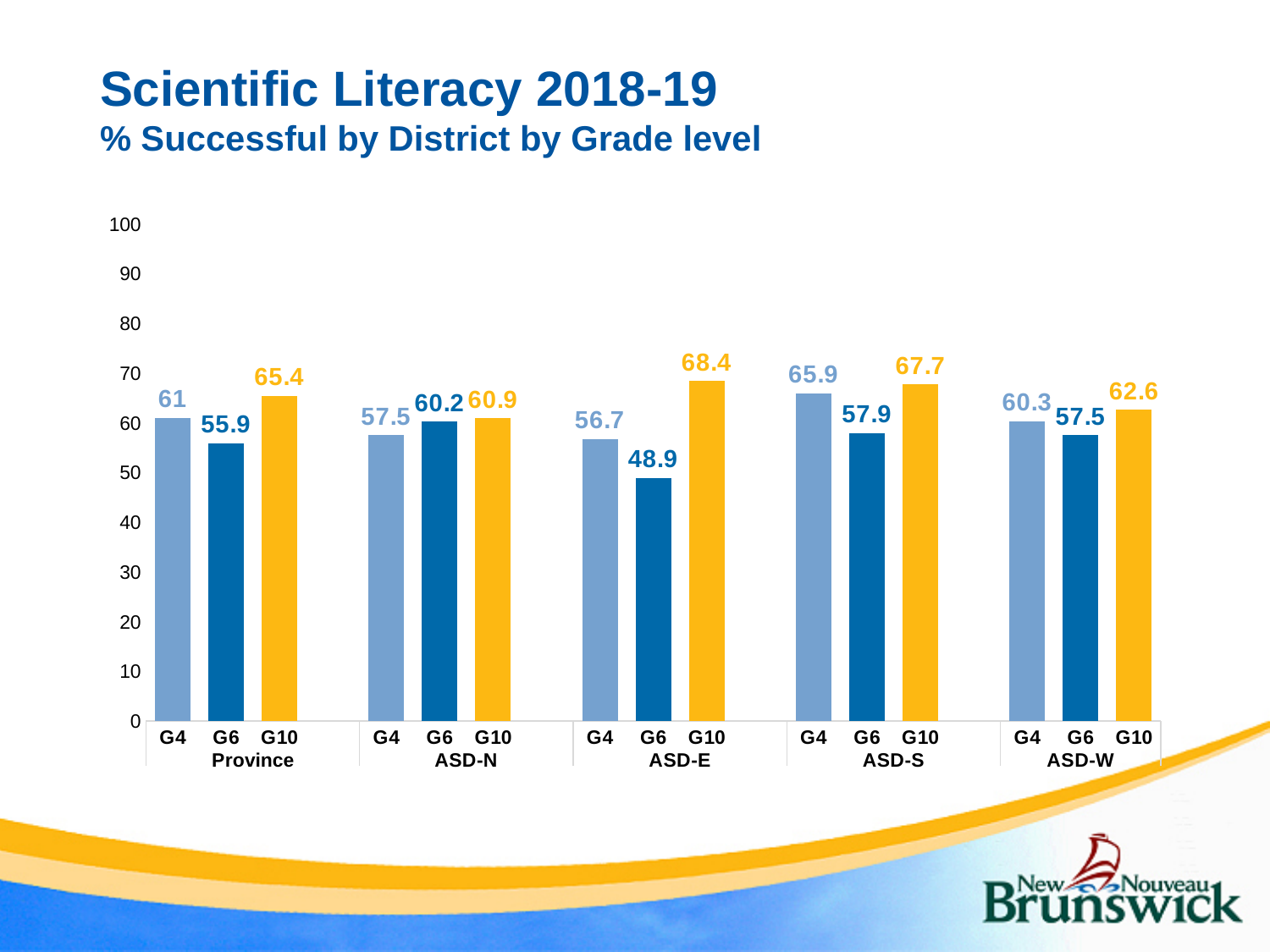
What is the value for G6 in the Province group? 55.9 Which bar has the lowest value on the chart? G6 in ASD-E (48.9) Which bar has the highest value on the chart? G10 in ASD-E (68.4) Which is larger, the G4 value in ASD-S or the G4 value in ASD-W? G4 in ASD-S What kind of chart is shown on the slide? bar chart What is the subtitle of the chart on the slide? % Successful by District by Grade level What is the difference between the G10 and G6 values in ASD-E? 19.5 How many district groups are shown on the x axis? 5 What is the value for G4 in ASD-S? 65.9 How many bars are plotted in total on the chart? 15 Is the value for G6 in ASD-E greater or less than 50? less What is the value for G10 in ASD-E? 68.4